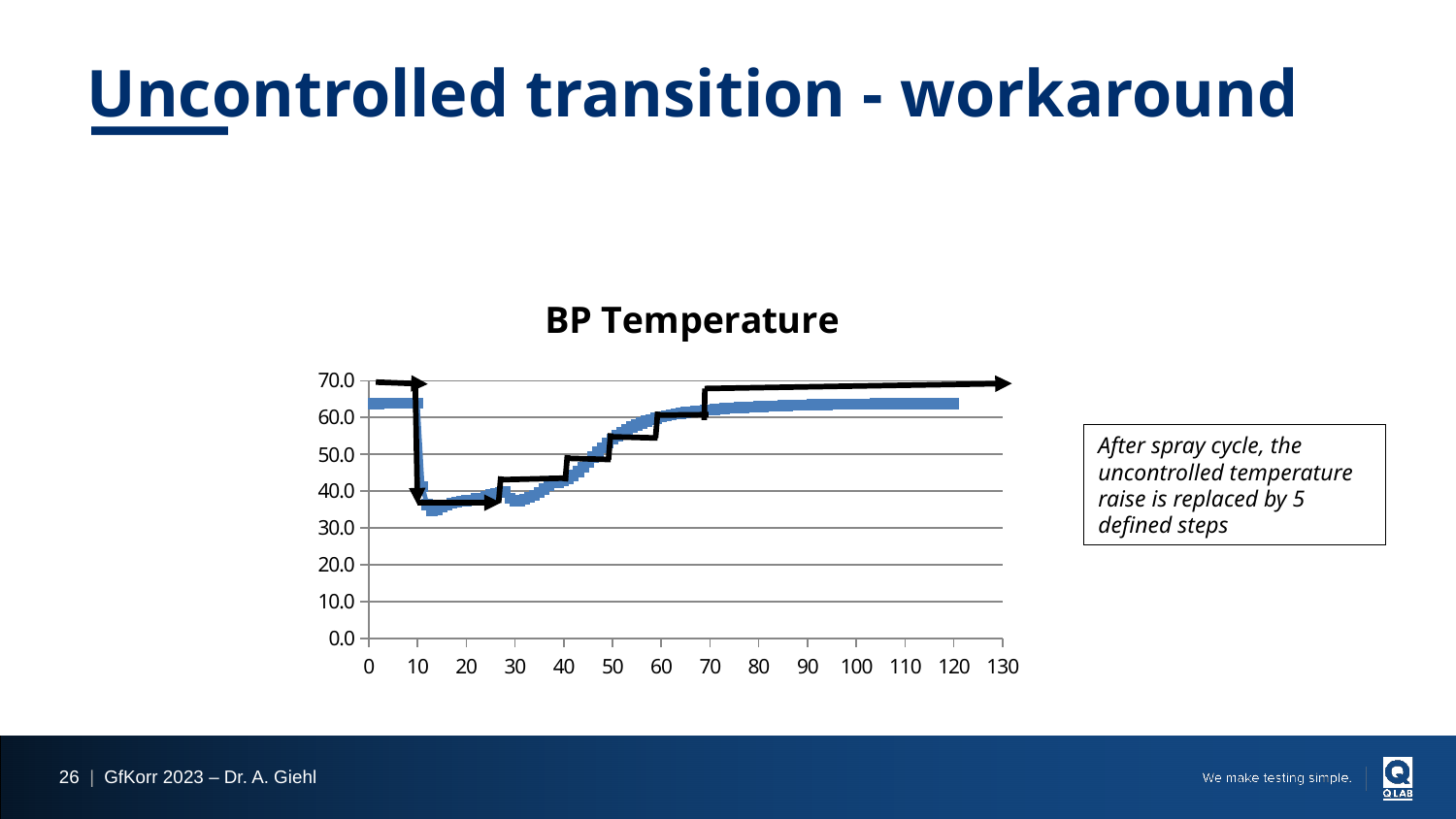
Is the blue BP Temperature value at x = 0 greater or less than 60.0? greater Between x = 20 and x = 70, do the blue BP Temperature values rise or fall? rise What is the highest value shown on the y axis of the BP Temperature chart? 70.0 Is the blue BP Temperature value at x = 20 greater or less than 40.0? less What kind of chart is shown on the slide? line chart Is the blue BP Temperature value at x = 60 greater or less than 50.0? greater Which is larger, the blue BP Temperature value at x = 0 or at x = 20? x = 0 What is the title of the chart? BP Temperature